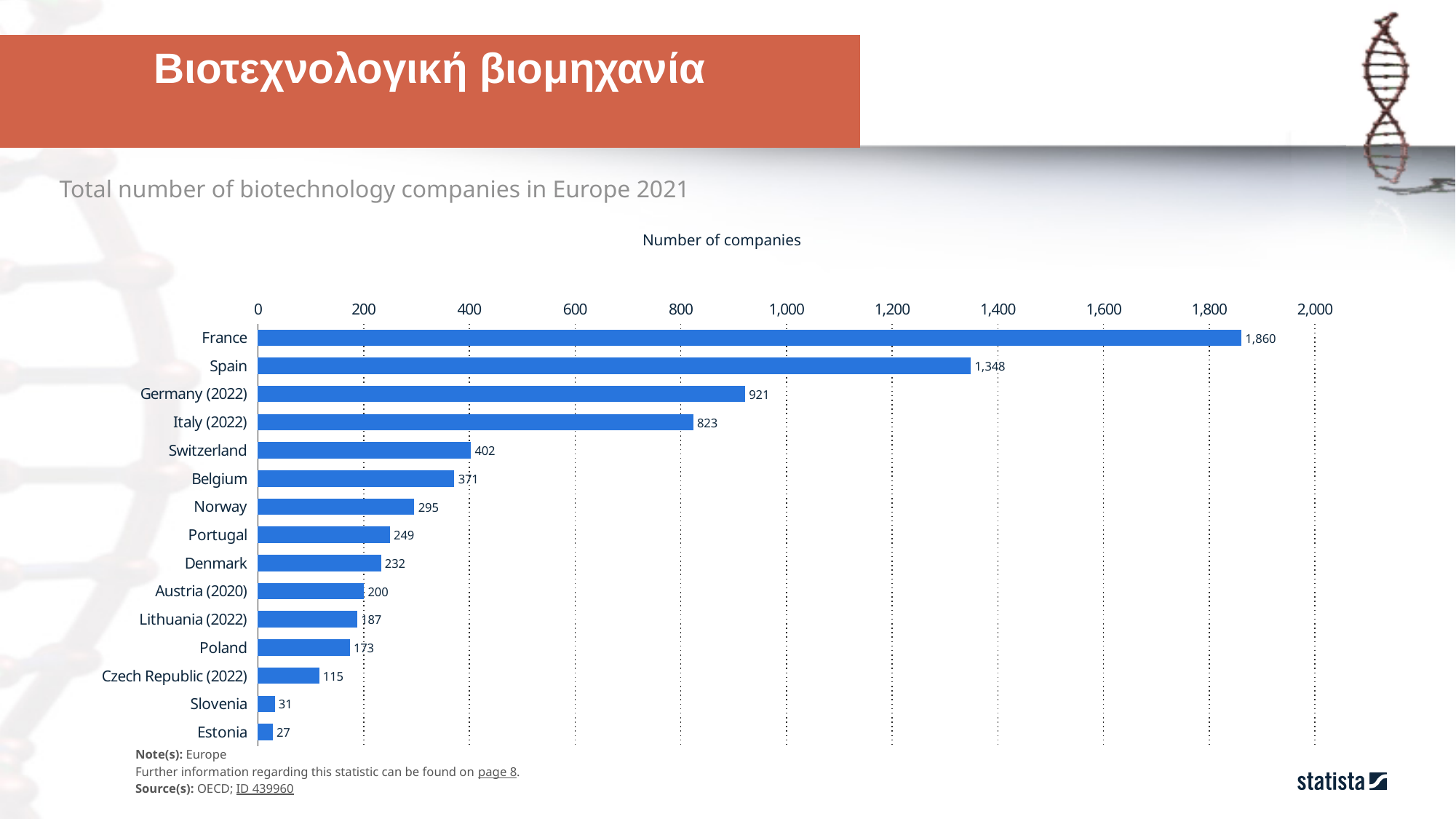
What is the difference between the number of companies in Spain and Germany (2022)? 427 What is the number of biotechnology companies in Czech Republic (2022)? 115 What is the difference between the number of companies in Slovenia and Estonia? 4 What is the number of biotechnology companies in France? 1,860 How many countries are shown in the chart? 15 Which has more biotechnology companies, Norway or Portugal? Norway What is the number of biotechnology companies in Switzerland? 402 What is the axis title shown above the chart? Number of companies Is the value for Italy (2022) greater or less than 1,000? less Which country has the highest number of biotechnology companies? France Which country has the lowest number of biotechnology companies? Estonia What kind of chart is shown on the slide? bar chart